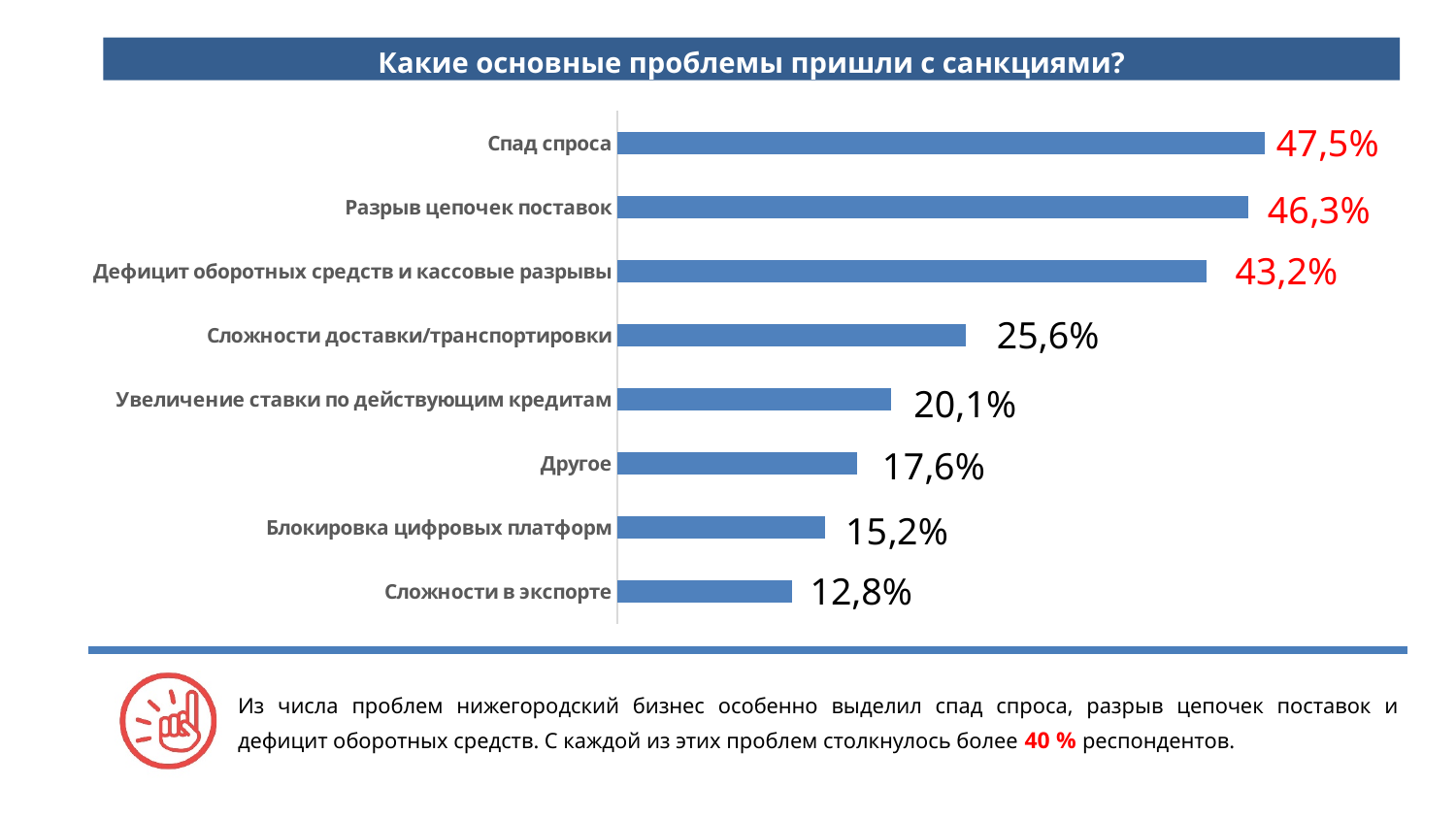
What is the value for Блокировка цифровых платформ? 15,2% Which is larger, the value for Увеличение ставки по действующим кредитам or the value for Другое? Увеличение ставки по действующим кредитам How many categories are shown in the chart? 8 Which category has the lowest value? Сложности в экспорте What kind of chart is shown on the slide? Bar chart What is the value for Разрыв цепочек поставок? 46,3% What is the title of the chart? Какие основные проблемы пришли с санкциями? What is the difference between the values for Спад спроса and Сложности в экспорте? 34,7% What is the value for Сложности доставки/транспортировки? 25,6% What is the value for Спад спроса? 47,5% What is the difference between the values for Дефицит оборотных средств и кассовые разрывы and Сложности доставки/транспортировки? 17,6% Which category has the highest value? Спад спроса